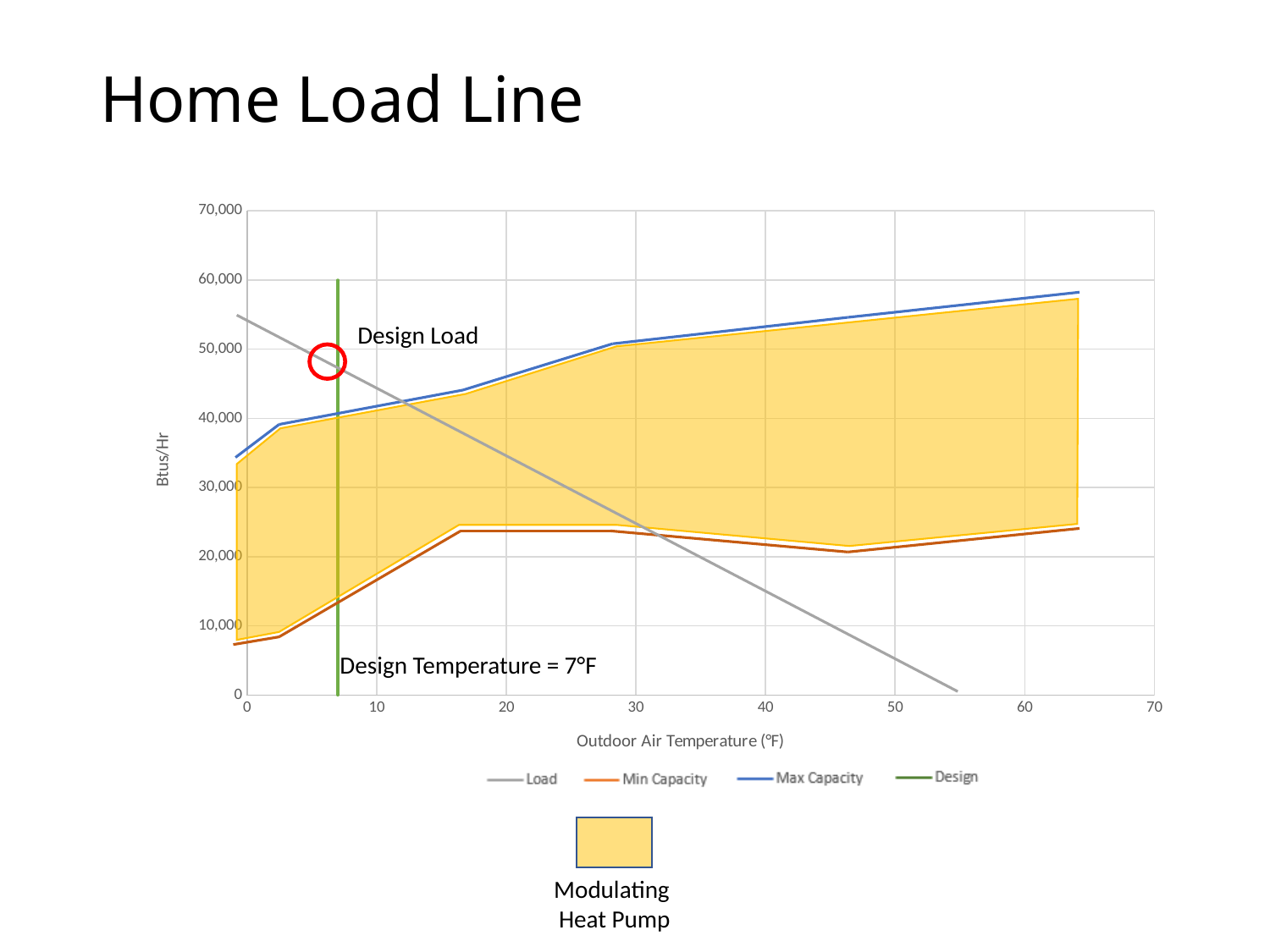
How many series does the chart legend list? 4 What kind of chart is shown on the slide? line chart At 50°F, which is larger: Min Capacity or Load? Min Capacity At 30°F, which is larger: Max Capacity or Load? Max Capacity Is the Load value at 0°F greater or less than 50,000? greater Which series are listed in the chart legend? Load, Min Capacity, Max Capacity, Design Is the Max Capacity value at 60°F greater or less than 50,000? greater Is the Min Capacity value at 40°F greater or less than 30,000? less What is the label on the vertical axis of the chart? Btus/Hr Does the Load line rise or fall as outdoor air temperature increases? fall Does the Max Capacity line rise or fall as outdoor air temperature increases? rise